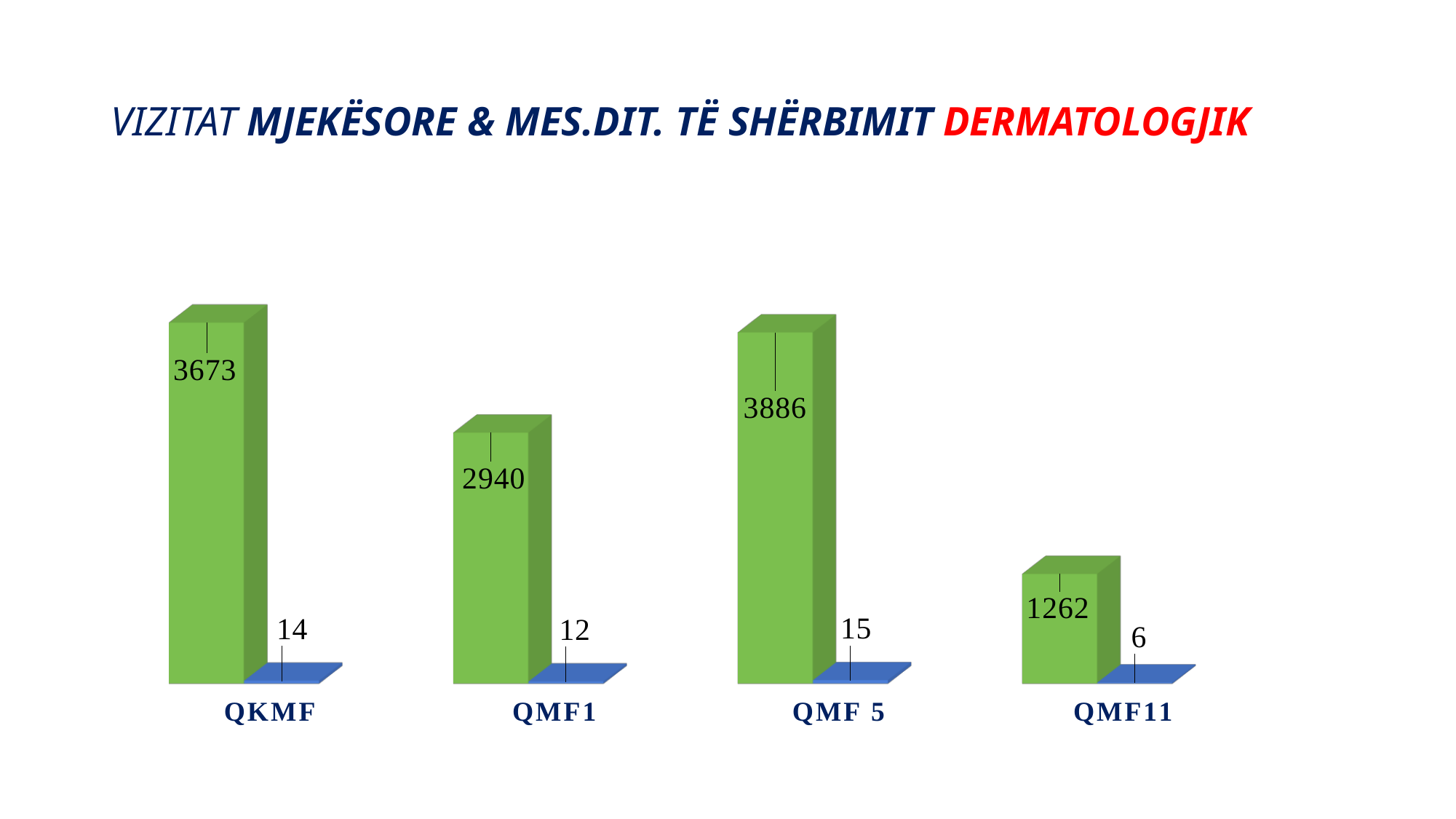
What is the difference between the green bar values for QMF 5 and QKMF? 213 What is the value of the blue bar for QMF1? 12 What is the value of the green bar for QKMF? 3673 What is the value of the blue bar for QMF 5? 15 How many categories are shown on the x axis? 4 Which category has the lowest blue bar? QMF11 Which has a larger green bar value, QKMF or QMF1? QKMF What is the value of the green bar for QMF11? 1262 What kind of chart is shown on the slide? Bar chart What is the difference between the green bar values for QMF1 and QMF11? 1678 What colour are the bars showing the larger values (e.g. 3673, 2940)? Green